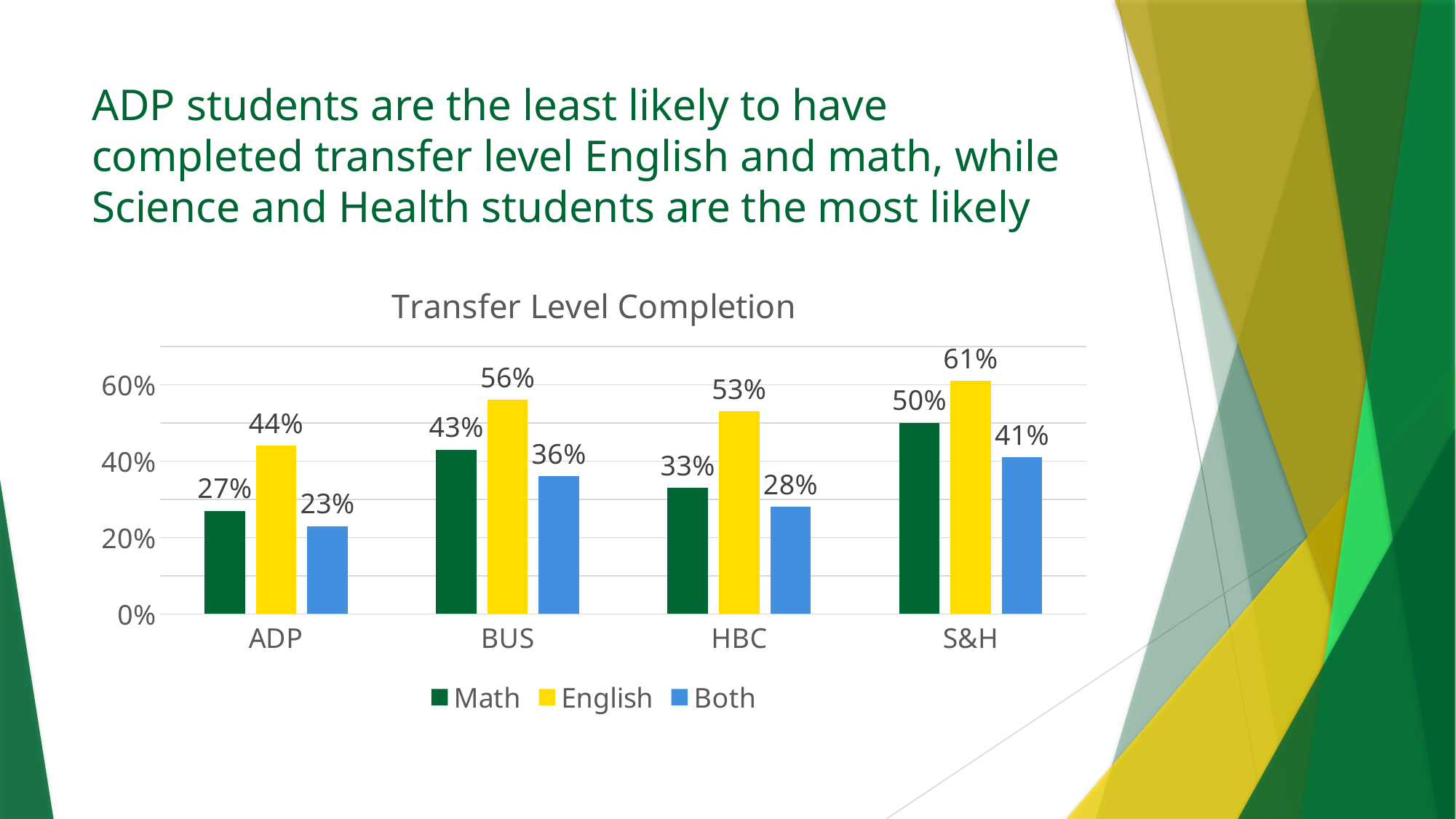
Which category has the highest English completion value? S&H Which category has the lowest Both value? ADP What kind of chart is shown? bar chart What is the Both value for S&H? 41% What is the Math completion value for ADP? 27% How many series does the legend list? 3 What is the title of the chart? Transfer Level Completion What is the difference between the English and Math values for BUS? 13% Which is larger, the Math value for HBC or the Math value for BUS? BUS Is the English value for S&H greater or less than 60%? greater What is the English completion value for HBC? 53% How many categories are shown on the x axis? 4